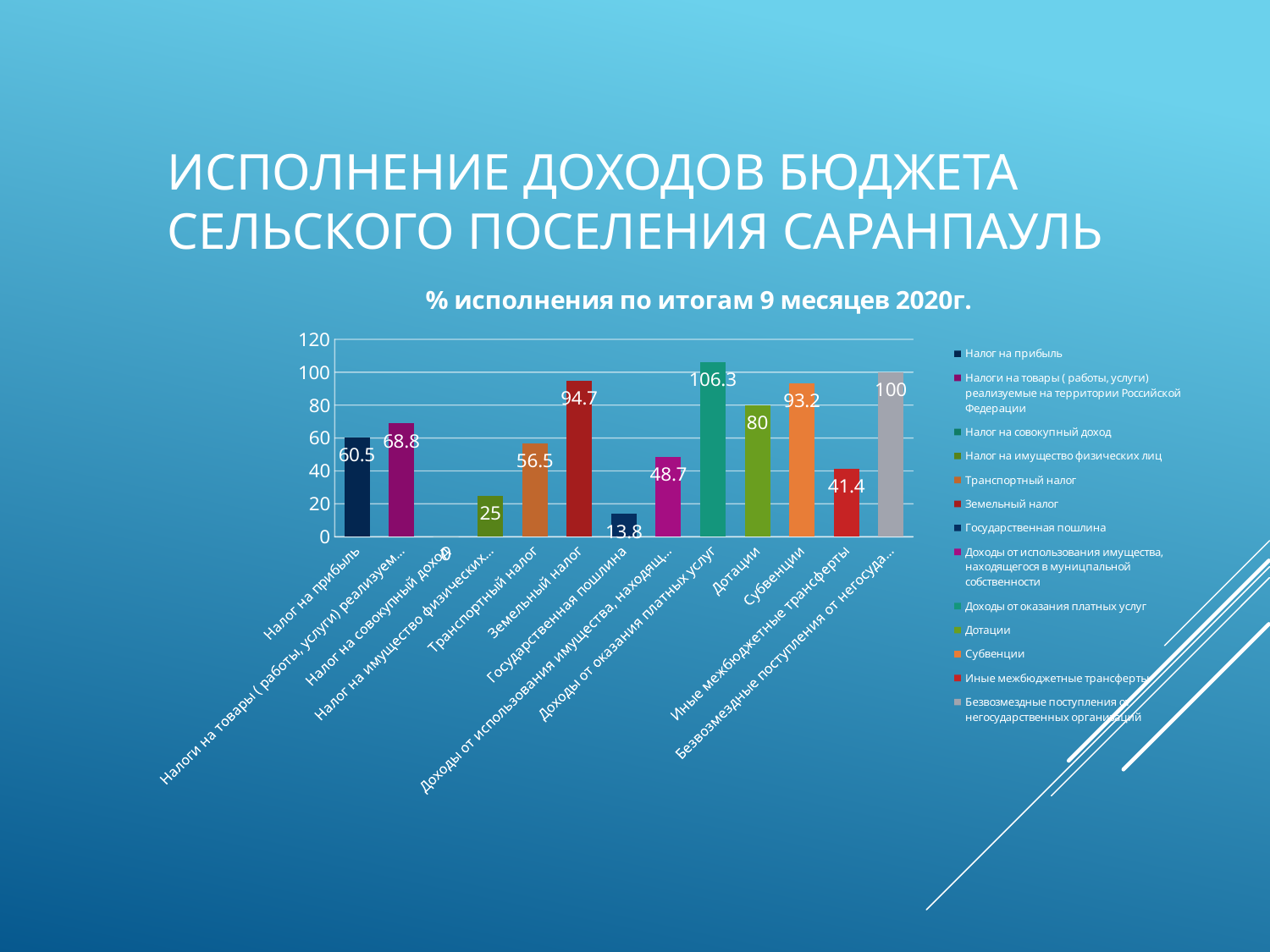
Which category has the highest value? Доходы от оказания платных услуг Is the value for Земельный налог greater or less than 80? greater What is the value for Транспортный налог? 56.5 What is the title of the chart? % исполнения по итогам 9 месяцев 2020г. What is the value for Государственная пошлина? 13.8 Which category has the lowest value? Налог на совокупный доход Which is larger, the value for Налог на прибыль or the value for Дотации? Дотации What is the value for Земельный налог? 94.7 What kind of chart is shown on the slide? bar chart How many categories are shown in the chart? 13 What is the value for Дотации? 80 What is the difference between the values for Субвенции and Иные межбюджетные трансферты? 51.8